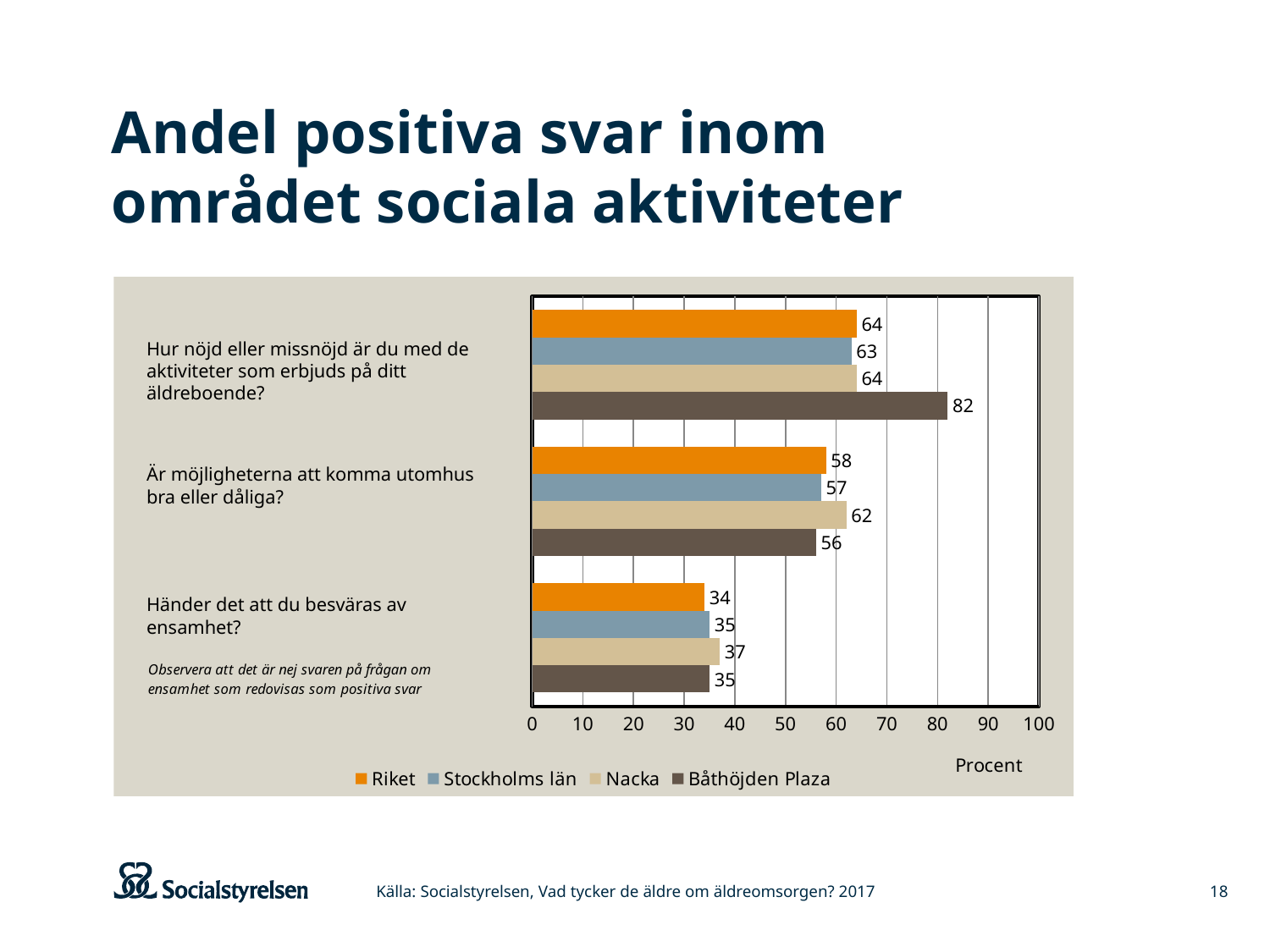
What is the label of the horizontal axis? Procent Which series has the highest value on the question "Hur nöjd eller missnöjd är du med de aktiviteter som erbjuds på ditt äldreboende?"? Båthöjden Plaza What is the value for Nacka on the question "Är möjligheterna att komma utomhus bra eller dåliga?"? 62 How many questions (categories) are shown on the chart? 3 How many series does the legend list? 4 What is the value for Riket on the question "Händer det att du besväras av ensamhet?"? 34 Which series has the lowest value on the question "Är möjligheterna att komma utomhus bra eller dåliga?"? Båthöjden Plaza What is the value for Båthöjden Plaza on the question "Hur nöjd eller missnöjd är du med de aktiviteter som erbjuds på ditt äldreboende?"? 82 What is the value for Stockholms län on the question "Hur nöjd eller missnöjd är du med de aktiviteter som erbjuds på ditt äldreboende?"? 63 What is the difference between Båthöjden Plaza and Riket on the question "Hur nöjd eller missnöjd är du med de aktiviteter som erbjuds på ditt äldreboende?"? 18 Which is larger on the question "Är möjligheterna att komma utomhus bra eller dåliga?": Nacka or Stockholms län? Nacka What kind of chart is shown on the slide? Bar chart